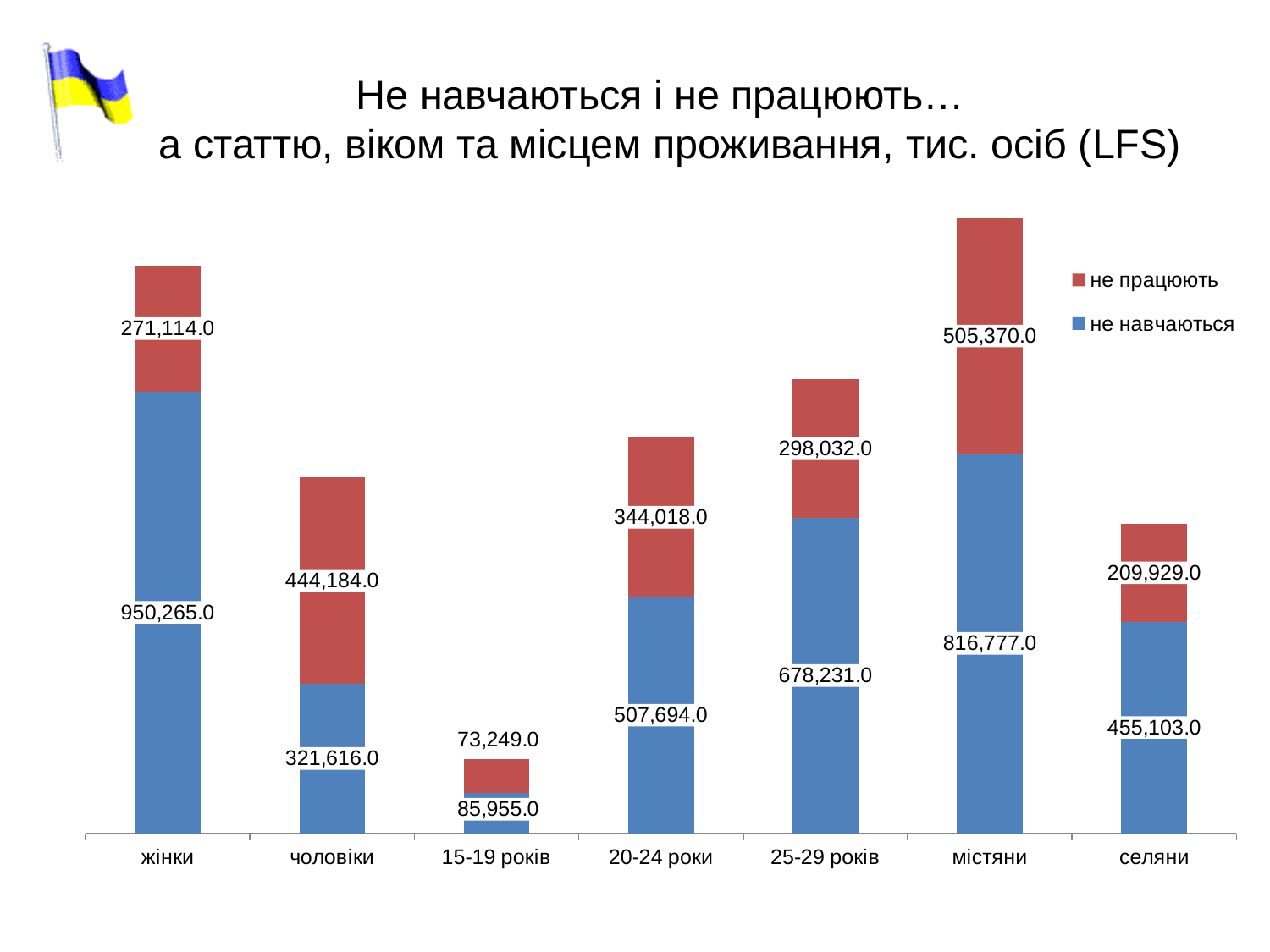
How many categories are shown on the x axis? 7 What is the value of "не працюють" for чоловіки? 444,184.0 How many series does the legend list? 2 Which is larger: the "не працюють" value for містяни or for селяни? містяни What is the value of "не навчаються" for жінки? 950,265.0 What is the value of "не навчаються" for селяни? 455,103.0 What is the difference between the "не навчаються" values for жінки and чоловіки? 628,649.0 What is the value of "не працюють" for 25-29 років? 298,032.0 What kind of chart is shown on the slide? stacked bar chart Which category has the highest value for "не навчаються"? жінки Which category has the lowest value for "не працюють"? 15-19 років What is the total of the stacked bar for селяни? 665,032.0